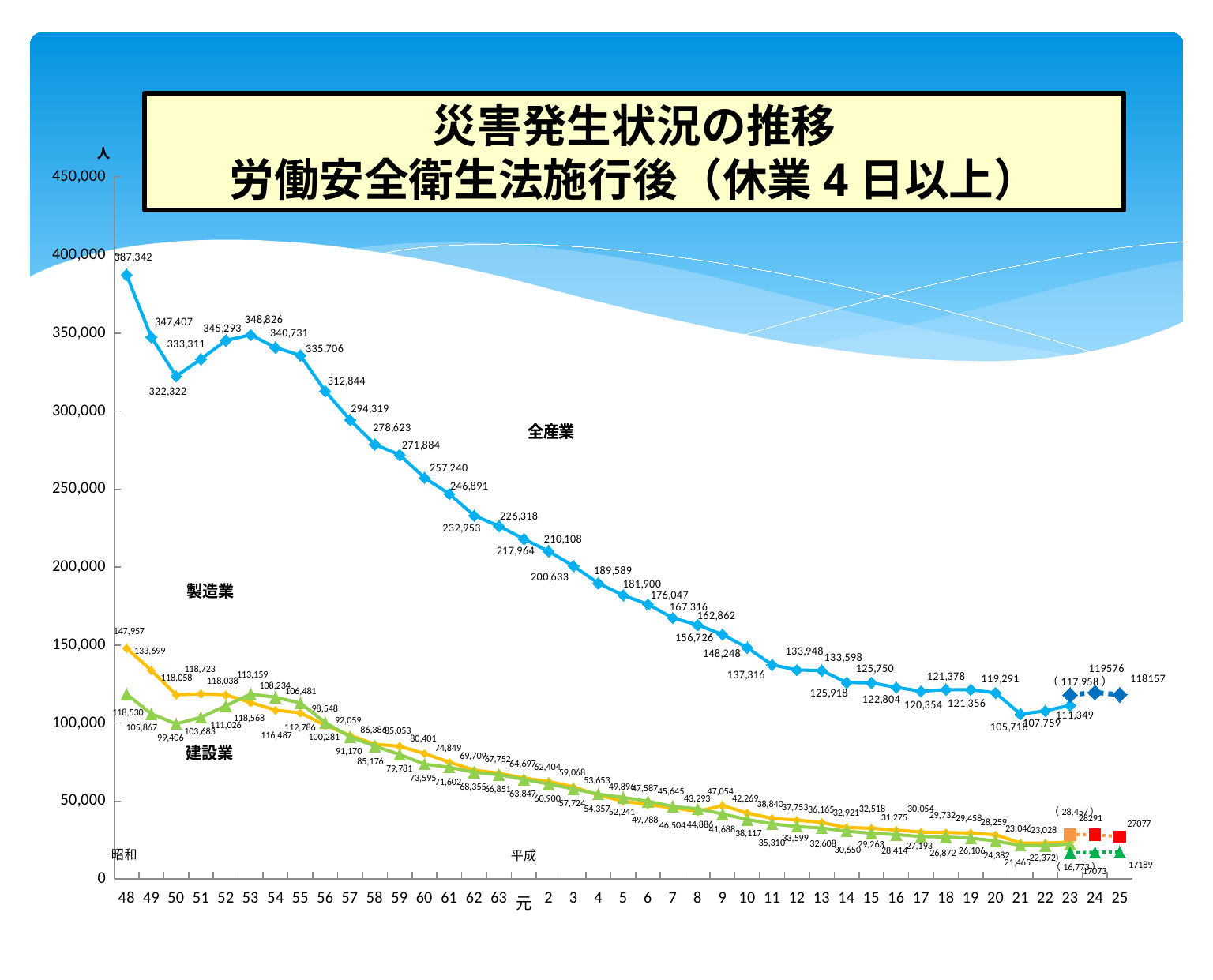
What is the value of 製造業 for 昭和48? 147,957 How many data series are plotted on the chart? 6 What is the difference between the 全産業 values for 昭和48 and 昭和49? 39,935 Does the 全産業 series generally rise or fall from 昭和48 to 平成25? fall Which series has the larger value in 昭和48, 製造業 or 建設業? 製造業 What is the value of 全産業 for 昭和48? 387,342 In which year does the 全産業 series reach its lowest value? 平成21 In which year does the 全産業 series reach its highest value? 昭和48 What is the value of 建設業 for 昭和48? 118,530 What kind of chart is shown on the slide? line chart What unit is shown at the top of the vertical axis? 人 What is the value of 全産業 for 平成25? 118157